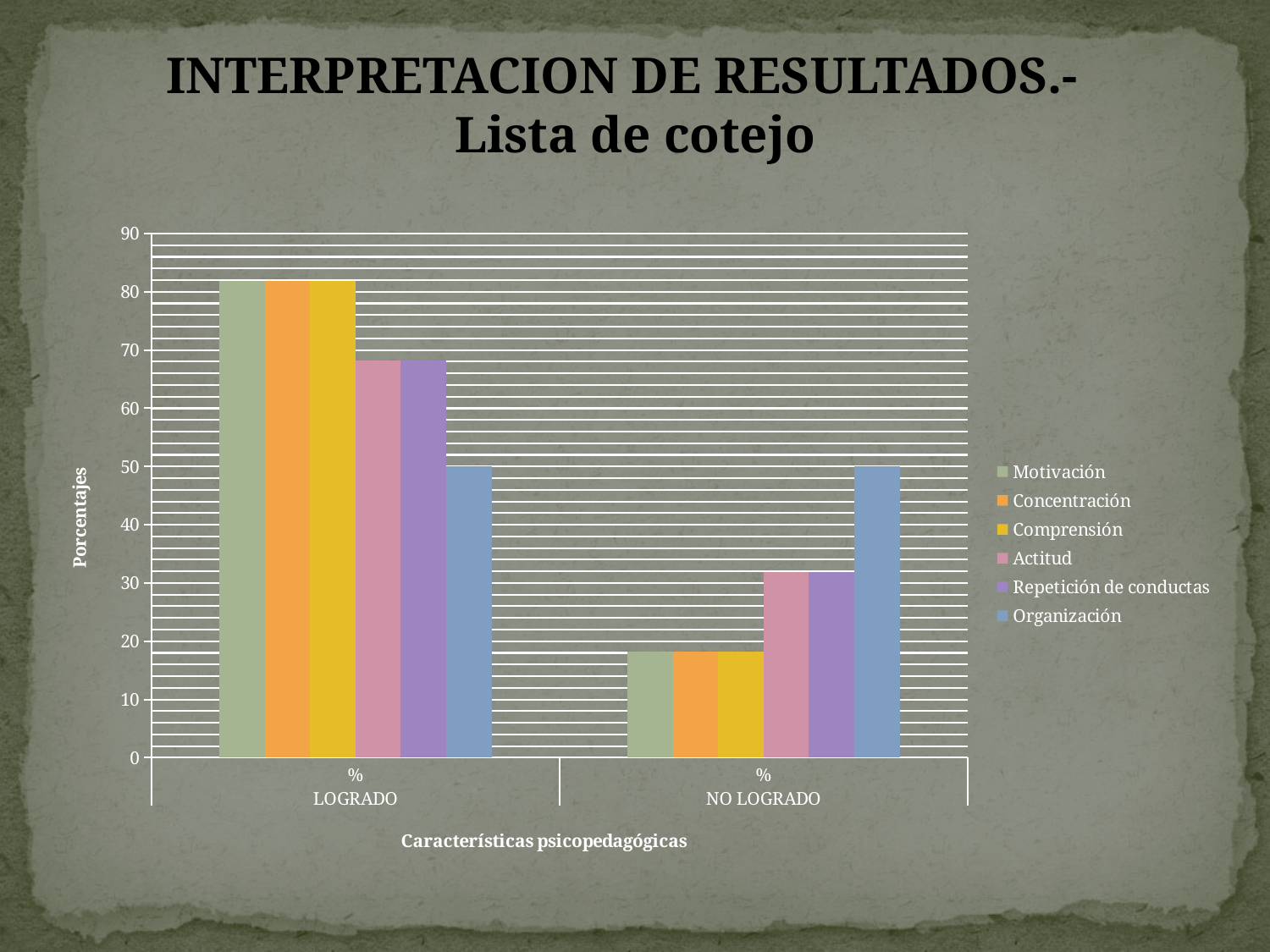
Which series has the lowest value in the LOGRADO category? Organización Which series has the highest value in the NO LOGRADO category? Organización Is the value for Actitud in the LOGRADO category greater or less than 60? greater Which is larger for Motivación: the LOGRADO value or the NO LOGRADO value? LOGRADO Is the value for Concentración in the NO LOGRADO category greater or less than 30? less Is the value for Repetición de conductas in the NO LOGRADO category greater or less than 40? less How many series does the legend list? 6 What is the title of the vertical axis? Porcentajes How many categories are shown on the x axis? 2 What kind of chart is shown on the slide? bar chart What is the value for Organización in the LOGRADO category? 50